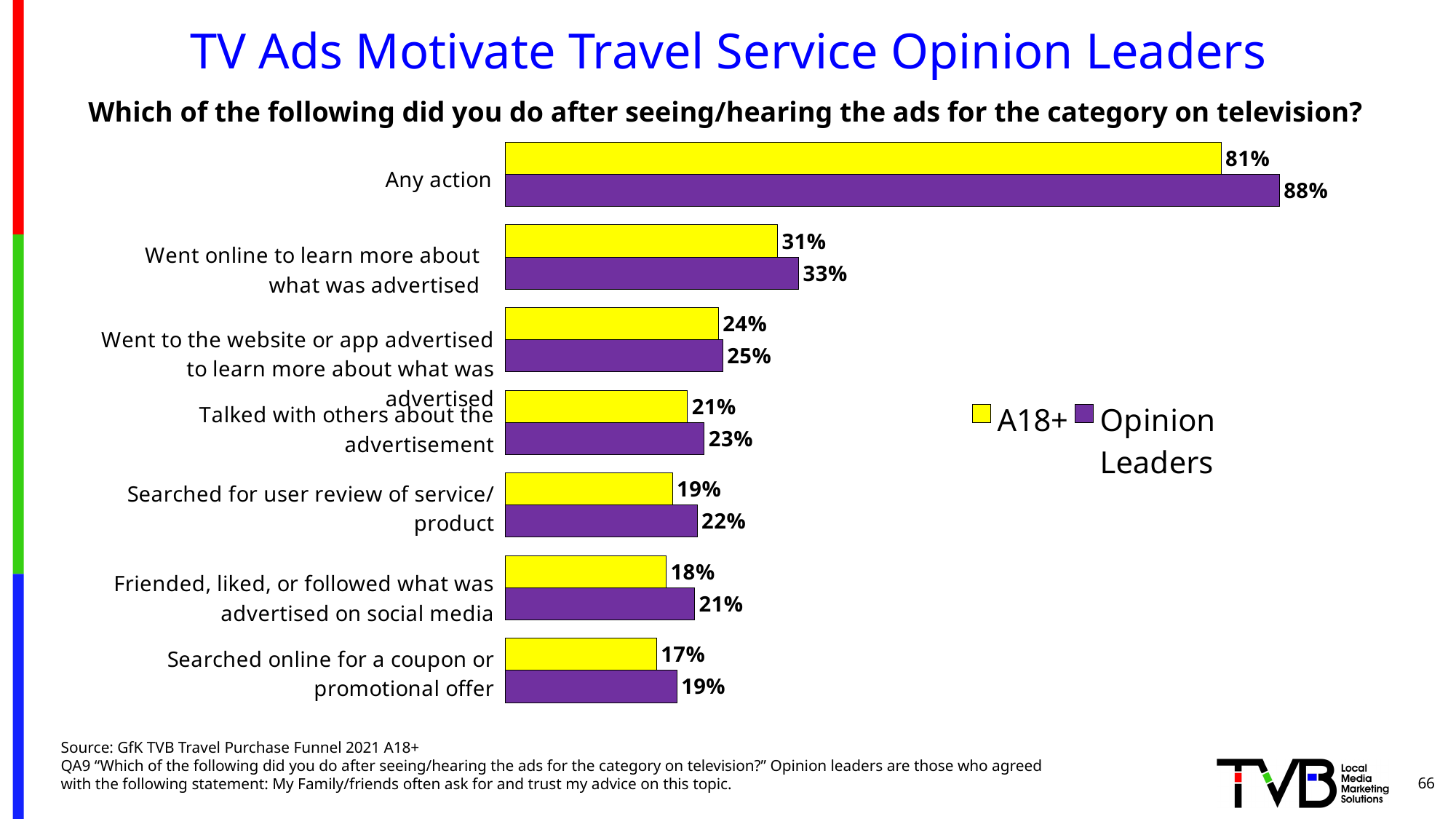
Which colour represents the Opinion Leaders series in the chart? Purple How many series does the legend list? 2 Which category has the highest value for Opinion Leaders? Any action What is the difference between the Opinion Leaders and A18+ values for "Any action"? 7% Which category has the lowest value for A18+? Searched online for a coupon or promotional offer What percentage of Opinion Leaders took any action after seeing/hearing the ads? 88% What is the A18+ value for "Went online to learn more about what was advertised"? 31% How many categories are shown in the chart? 7 What is the A18+ value for "Friended, liked, or followed what was advertised on social media"? 18% For "Searched for user review of service/product", which series has the larger value, A18+ or Opinion Leaders? Opinion Leaders What type of chart is shown on the slide? Bar chart What percentage of Opinion Leaders searched online for a coupon or promotional offer? 19%